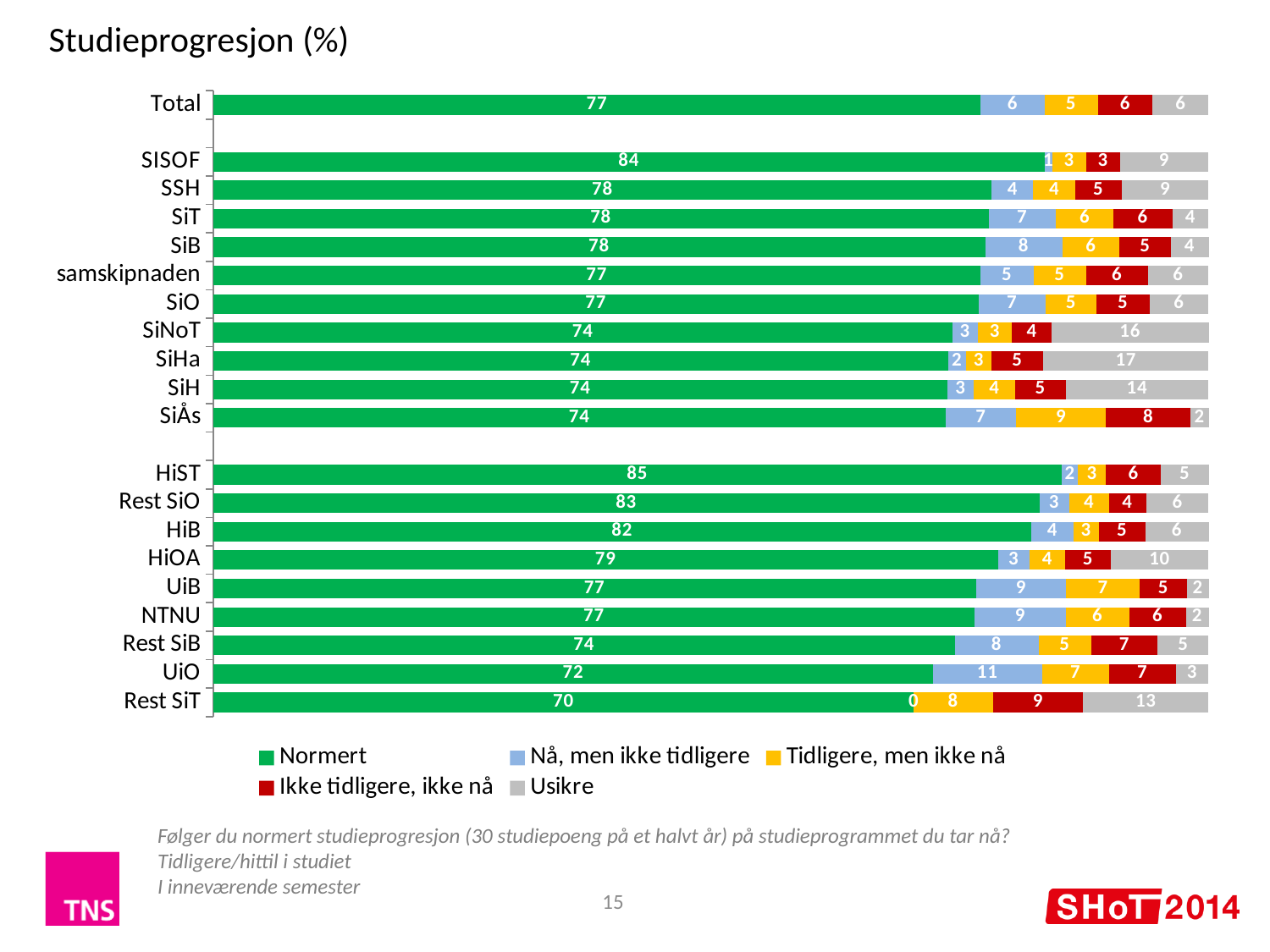
Which category has the highest Normert value? HiST How many categories (bars) are plotted in the chart? 20 What is the Usikre value for SiHa? 17 Which category has the lowest Normert value? Rest SiT What is the total of the stacked bar for Total? 100 What is the Normert value for HiST? 85 What kind of chart is shown on the slide? stacked bar chart What is the title of the chart? Studieprogresjon (%) What is the 'Nå, men ikke tidligere' value for UiO? 11 How many series does the legend list? 5 What is the difference between the Normert value for HiST and the Normert value for Rest SiT? 15 Which has a larger 'Ikke tidligere, ikke nå' value, SiÅs or SiNoT? SiÅs